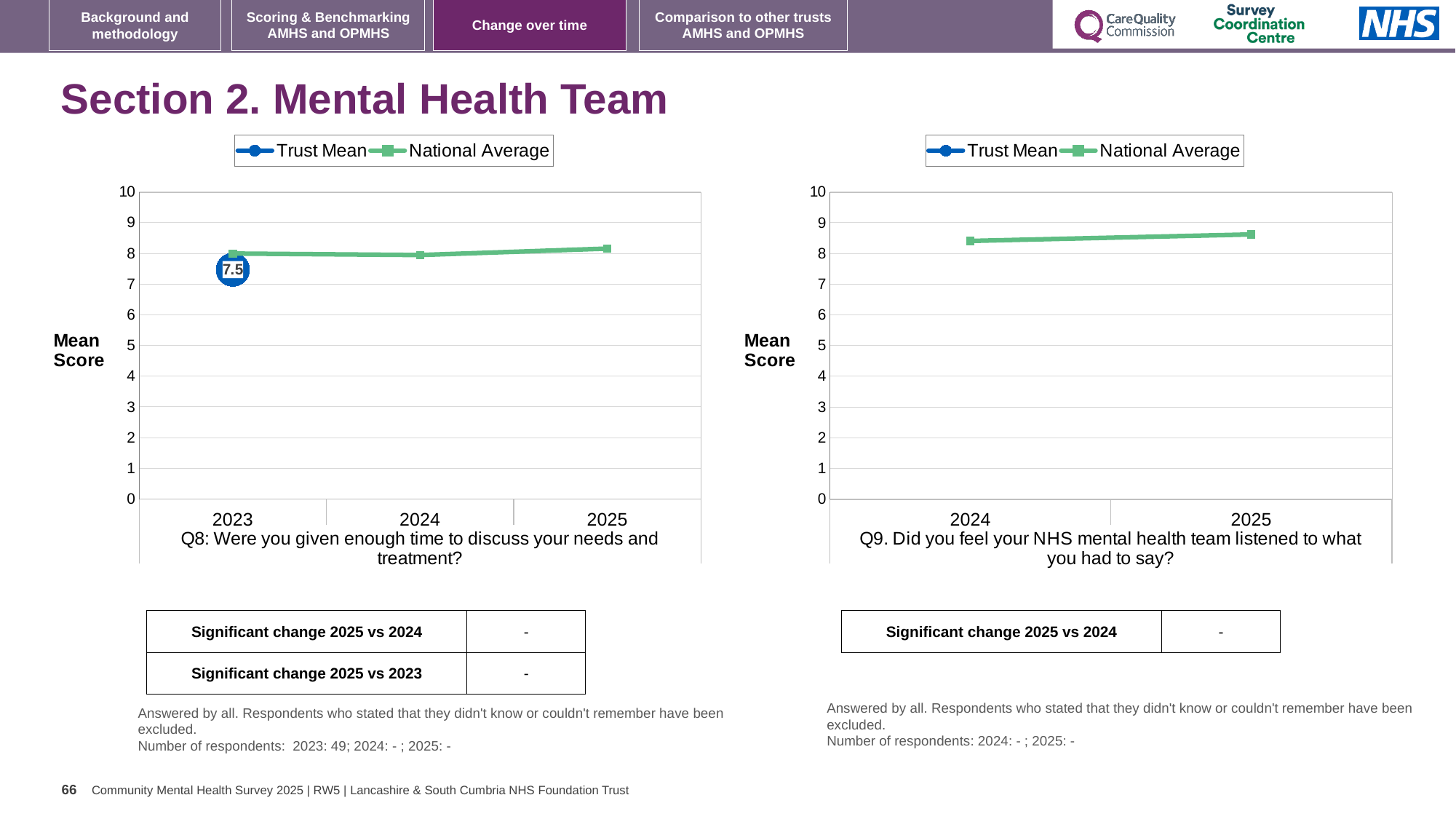
How many series does the legend of the right chart (Q9) list? 2 What kind of chart is the left chart (Q8)? line chart On the left chart (Q8), is the National Average value for 2025 greater or less than 7? greater On the left chart (Q8), which is larger for 2023: the Trust Mean or the National Average? National Average How many years are shown on the x axis of the left chart (Q8)? 3 On the right chart (Q9), is the National Average value for 2024 greater or less than 8? greater What is the label on the y axis of the right chart (Q9)? Mean Score On the left chart (Q8), what is the Trust Mean value for 2023? 7.5 On the right chart (Q9), does the National Average rise or fall from 2024 to 2025? rise What are the two series named in the legend of the left chart (Q8)? Trust Mean and National Average How many years are shown on the x axis of the right chart (Q9)? 2 On the left chart (Q8), is the Trust Mean value for 2023 greater or less than 8? less